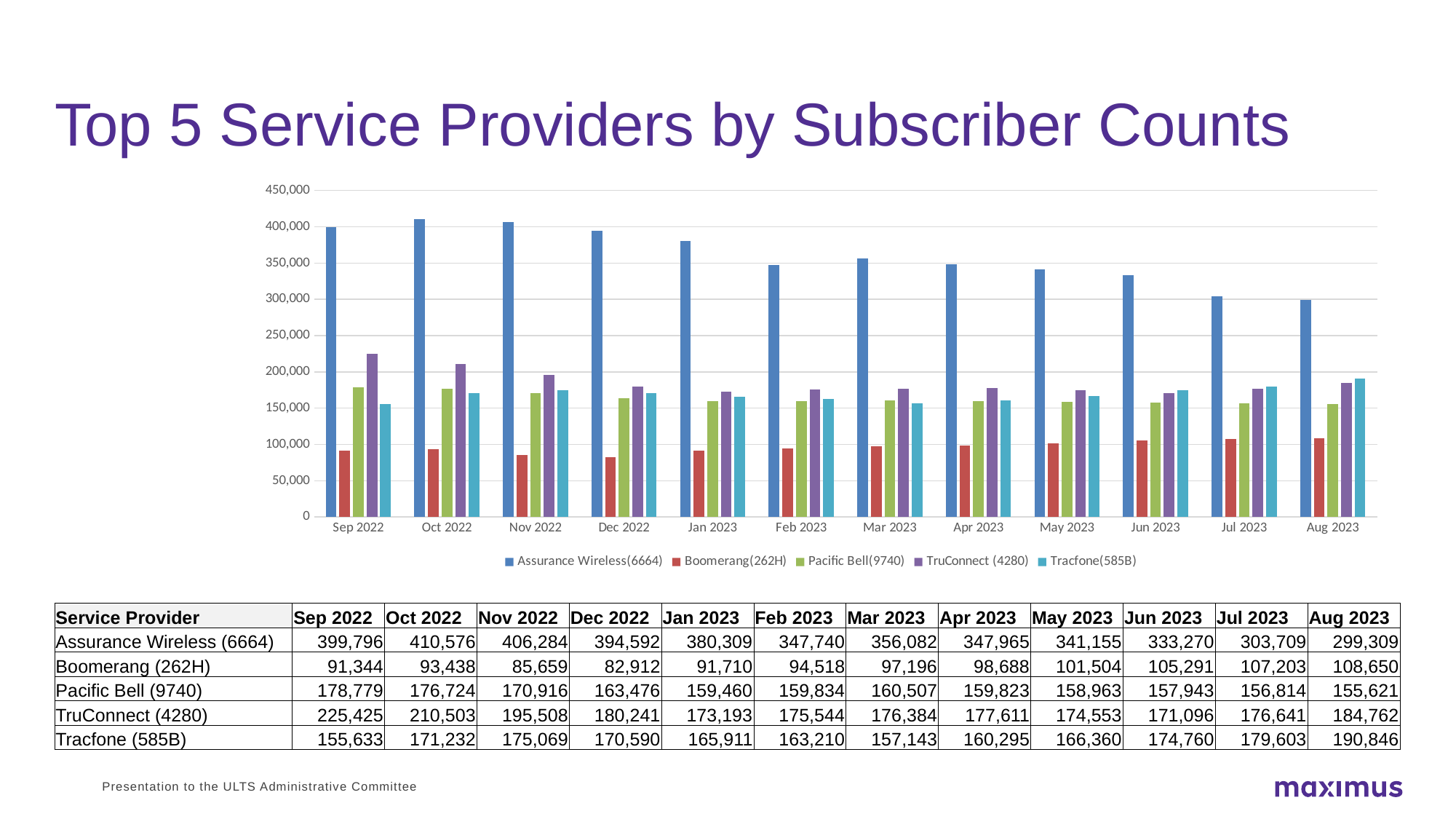
In Aug 2023, which has more subscribers: Tracfone (585B) or TruConnect (4280)? Tracfone (585B) What is the subscriber count for Tracfone (585B) in Aug 2023? 190,846 How many service providers does the chart legend list? 5 How many months are shown on the x axis of the chart? 12 Is the value for Assurance Wireless (6664) in Jul 2023 greater or less than 350,000? less Do the Boomerang (262H) subscriber counts rise or fall from Dec 2022 to Aug 2023? rise In which month does Boomerang (262H) have its lowest subscriber count? Dec 2022 What is the difference between the Assurance Wireless (6664) subscriber counts in Sep 2022 and Aug 2023? 100,487 In which month does Assurance Wireless (6664) have its highest subscriber count? Oct 2022 What colour represents Boomerang (262H) in the chart? red What kind of chart is shown on the slide? bar chart What is the subscriber count for Assurance Wireless (6664) in Sep 2022? 399,796